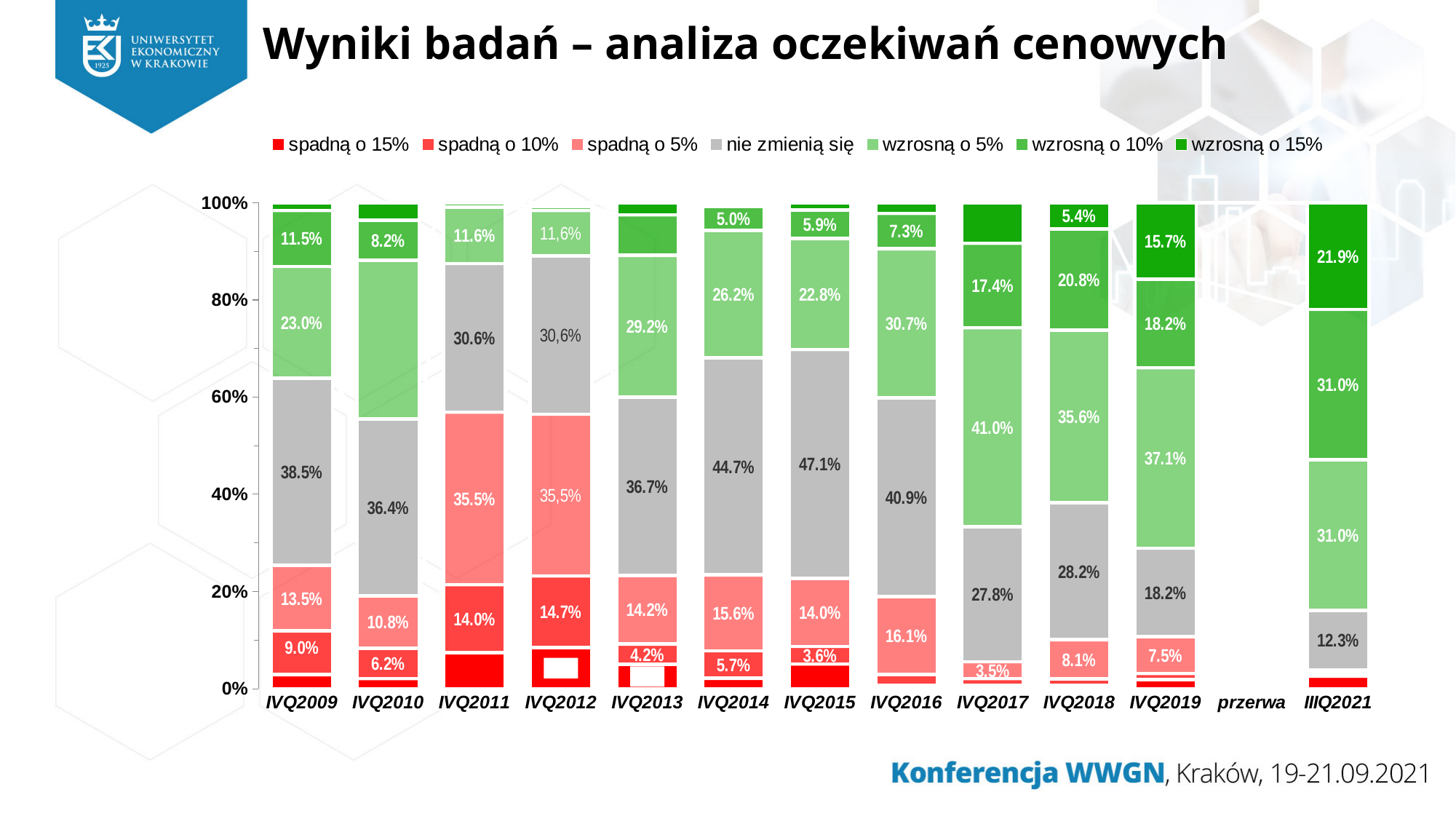
What kind of chart is shown on the slide? stacked bar chart What colour represents 'nie zmienią się' in the chart? grey How many series does the legend list? 7 What is the value of 'spadną o 10%' for IVQ2012? 14.7% What is the difference between the 'nie zmienią się' values for IVQ2009 and IVQ2019? 20.3 percentage points What is the value of 'nie zmienią się' for IVQ2015? 47.1% Which is larger, the 'wzrosną o 10%' value for IVQ2018 or for IVQ2019? IVQ2018 What is the value of 'spadną o 5%' for IVQ2016? 16.1% Which period has the lowest value for 'nie zmienią się'? IIIQ2021 Which period has the highest value for 'nie zmienią się'? IVQ2015 What is the value of 'wzrosną o 15%' for IIIQ2021? 21.9% What is the value of 'wzrosną o 5%' for IVQ2017? 41.0%